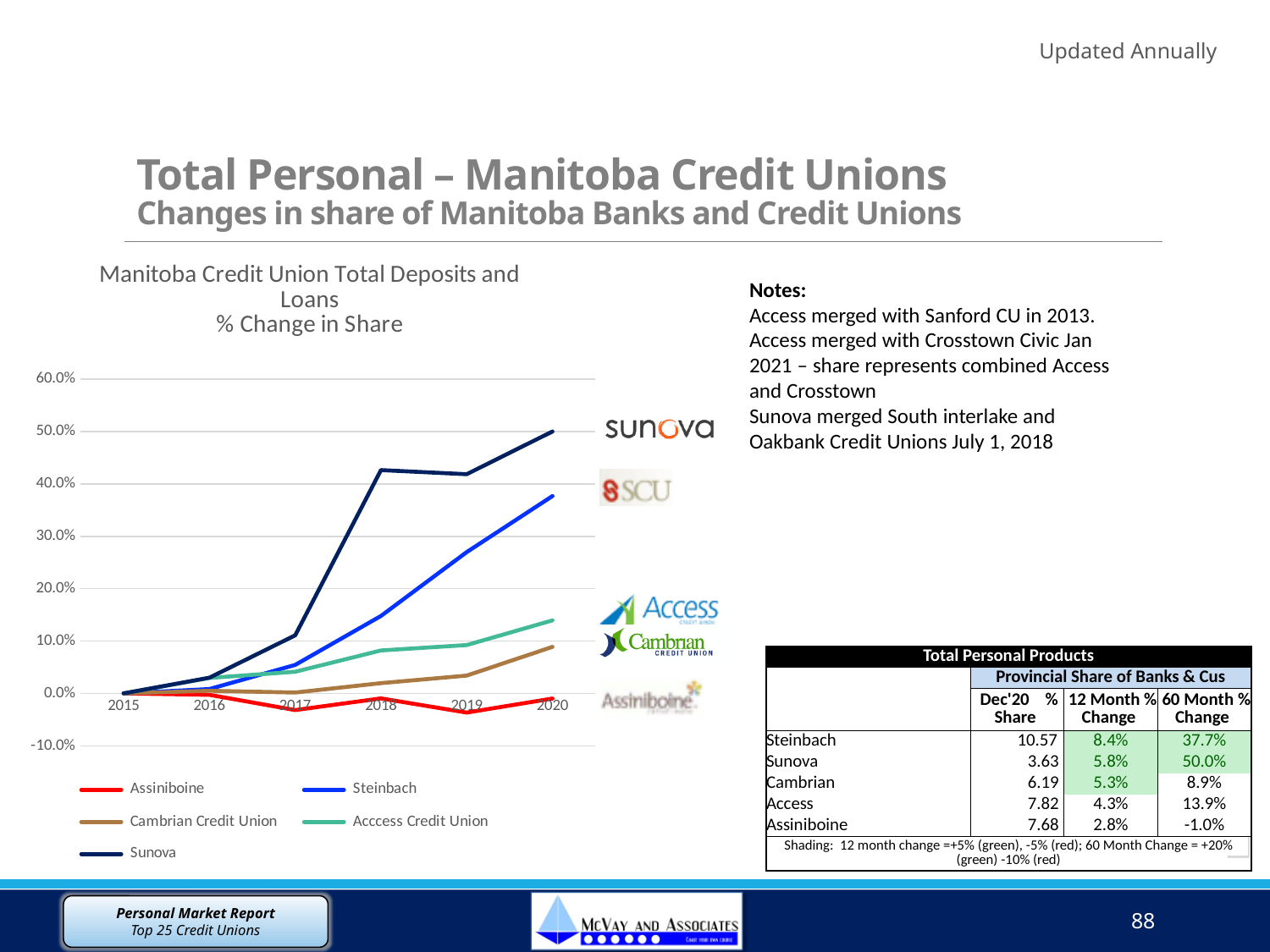
Which credit union has the highest % change in share in 2020? Sunova What is the % change in share for Steinbach in 2015? 0.0% What kind of chart is shown on the slide? line chart What is the % change in share for Sunova in 2020? 50.0% Which credit union has the lowest % change in share in 2020? Assiniboine Which is larger in 2018, the value for Sunova or the value for Steinbach? Sunova How many years are plotted along the x axis of the chart? 6 Is the value for Steinbach in 2020 greater or less than 30.0%? greater Is the value for Access Credit Union in 2020 greater or less than 20.0%? less Does the Sunova line generally rise or fall from 2015 to 2020? rise What colour is the Assiniboine line in the chart? red How many series does the chart's legend list? 5